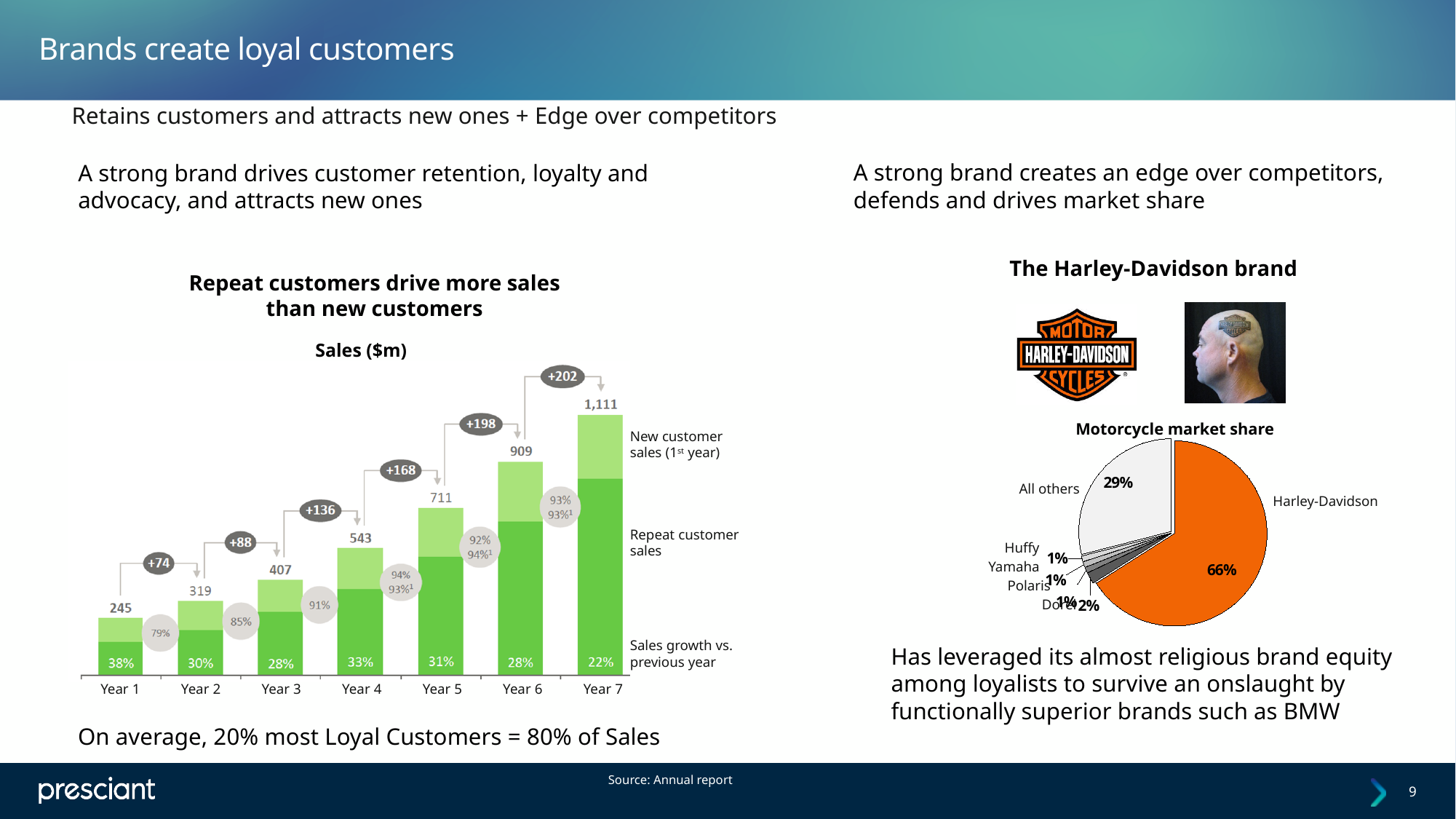
What kind of chart is the 'Repeat customers drive more sales than new customers' chart? Stacked bar chart In the 'Repeat customers drive more sales than new customers' chart, which year has the lowest total sales? Year 1 In the 'Repeat customers drive more sales than new customers' chart, what increase is shown between Year 3 and Year 4? +136 In the 'Repeat customers drive more sales than new customers' chart, what is the total sales value for Year 1? 245 In the 'Repeat customers drive more sales than new customers' chart, what is the difference between the total sales of Year 6 and Year 5? 198 In the 'Repeat customers drive more sales than new customers' chart, what is the total sales value for Year 7? 1,111 In the 'Repeat customers drive more sales than new customers' chart, which year has the highest total sales? Year 7 In the 'Motorcycle market share' pie chart, which brand has the largest slice? Harley-Davidson In the 'Repeat customers drive more sales than new customers' chart, do total sales rise or fall from Year 1 to Year 7? Rise In the 'Repeat customers drive more sales than new customers' chart, how many years are shown on the x axis? 7 In the 'Motorcycle market share' pie chart, what share does Harley-Davidson hold? 66% In the 'Motorcycle market share' pie chart, what share is labelled for 'All others'? 29%